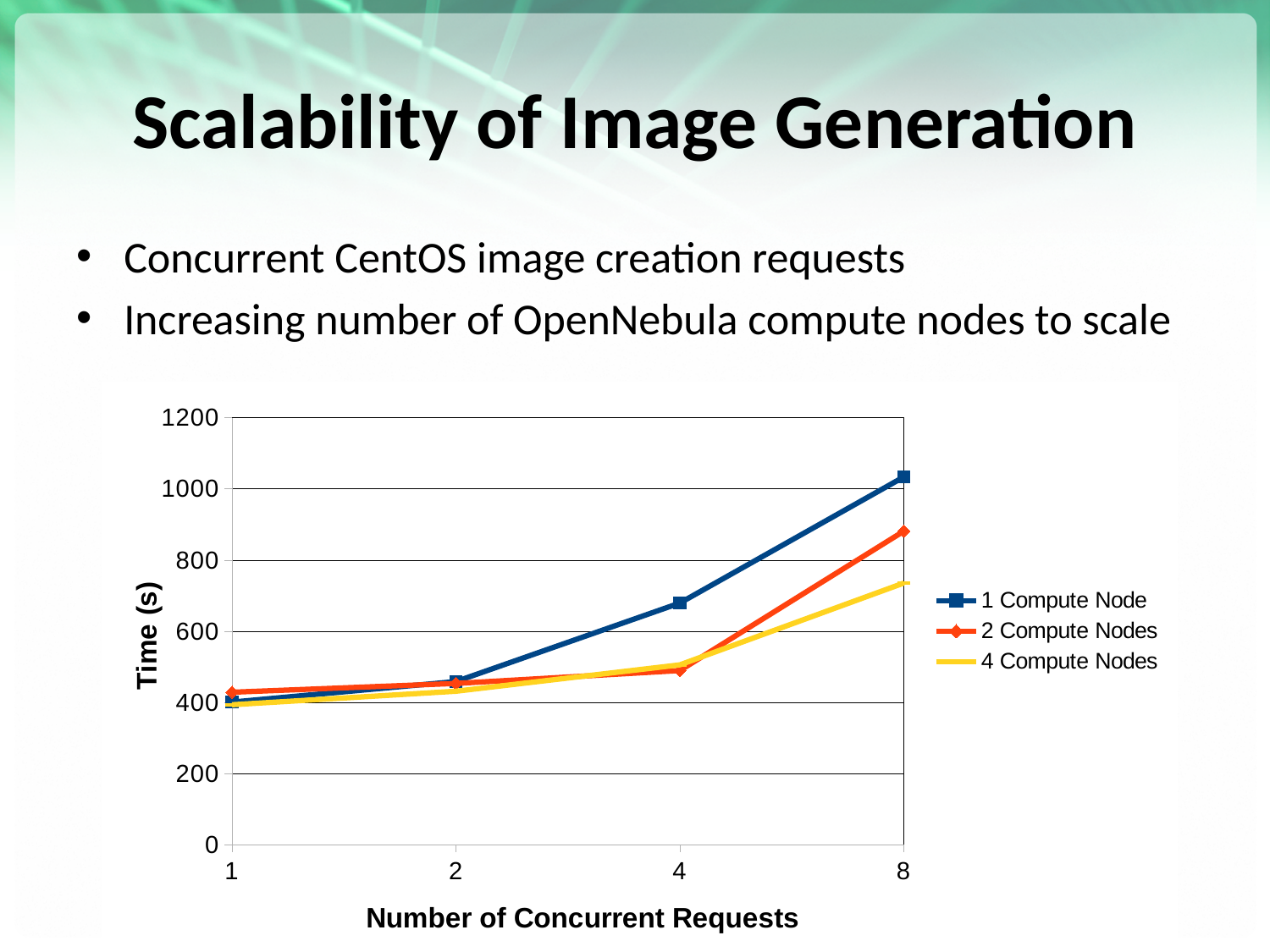
Does the time for 1 Compute Node rise or fall as the number of concurrent requests increases? rise What kind of chart is shown on the slide? line chart At 8 concurrent requests, which is larger: the time for 2 Compute Nodes or for 4 Compute Nodes? 2 Compute Nodes Which series has the lowest time at 8 concurrent requests? 4 Compute Nodes How many points along the x axis (Number of Concurrent Requests) are plotted for each series? 4 Is the value for 1 Compute Node at 4 concurrent requests greater or less than 600? greater Is the value for 1 Compute Node at 8 concurrent requests greater or less than 800? greater What is the title of the y axis? Time (s) Which series has the highest time at 8 concurrent requests? 1 Compute Node Is the value for 4 Compute Nodes at 8 concurrent requests greater or less than 800? less How many series does the legend list? 3